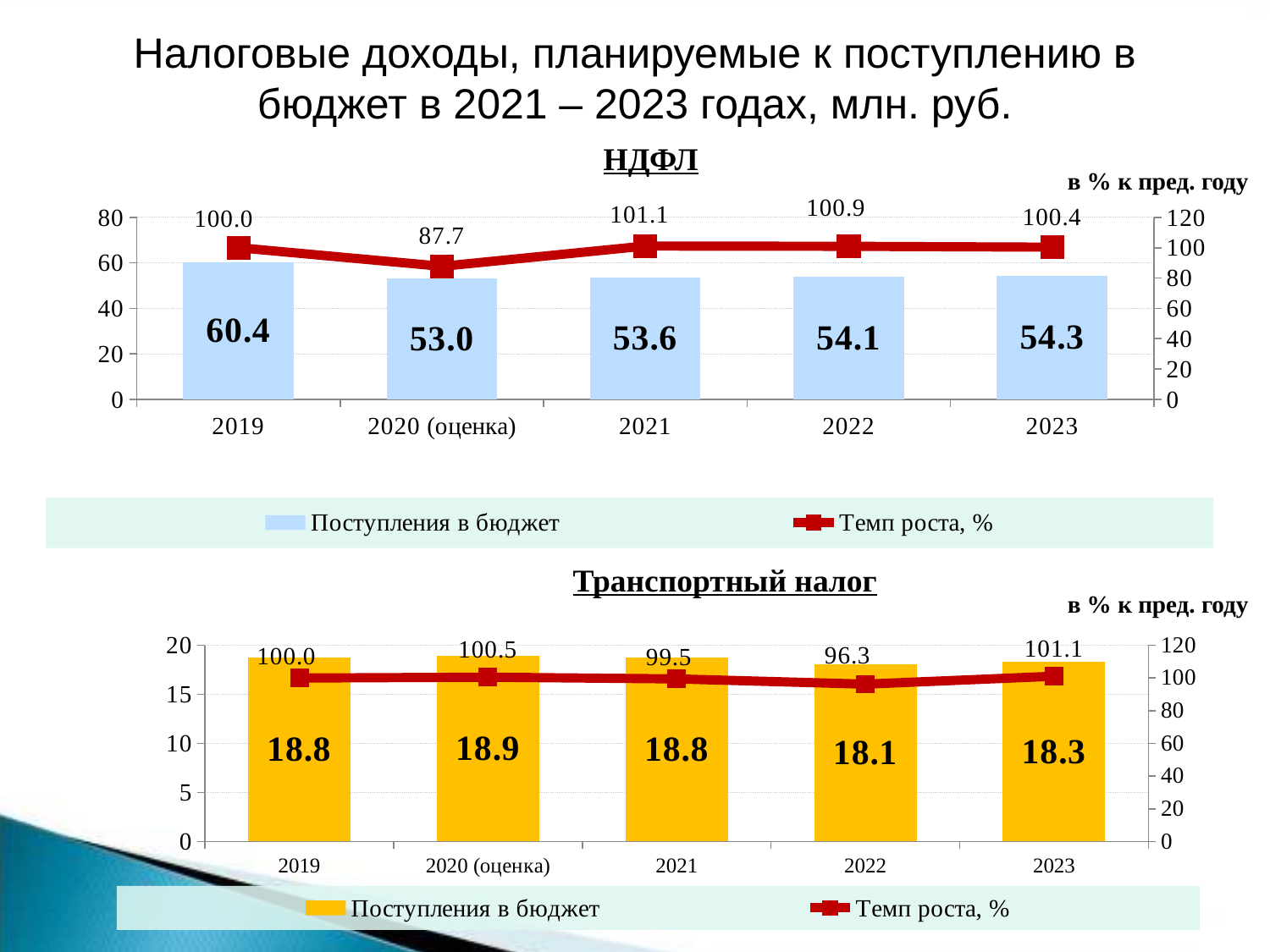
What kind of chart is the Транспортный налог chart? Combined bar and line chart In the НДФЛ chart, which year has the lowest Поступления в бюджет value? 2020 (оценка) In the НДФЛ chart, what is the value of Поступления в бюджет for 2019? 60.4 In the НДФЛ chart, which year has the highest Темп роста, % value? 2021 In the НДФЛ chart, what is the Темп роста, % value for 2020 (оценка)? 87.7 How many years are shown on the x axis of the Транспортный налог chart? 5 In the Транспортный налог chart, which year has the lowest Темп роста, % value? 2022 In the Транспортный налог chart, what is the Темп роста, % value for 2023? 101.1 In the Транспортный налог chart, what is the value of Поступления в бюджет for 2022? 18.1 In the НДФЛ chart, how many series does the legend list? 2 In the Транспортный налог chart, is the Поступления в бюджет value for 2021 larger or smaller than for 2022? larger In the НДФЛ chart, what is the difference between the Поступления в бюджет values for 2019 and 2020 (оценка)? 7.4